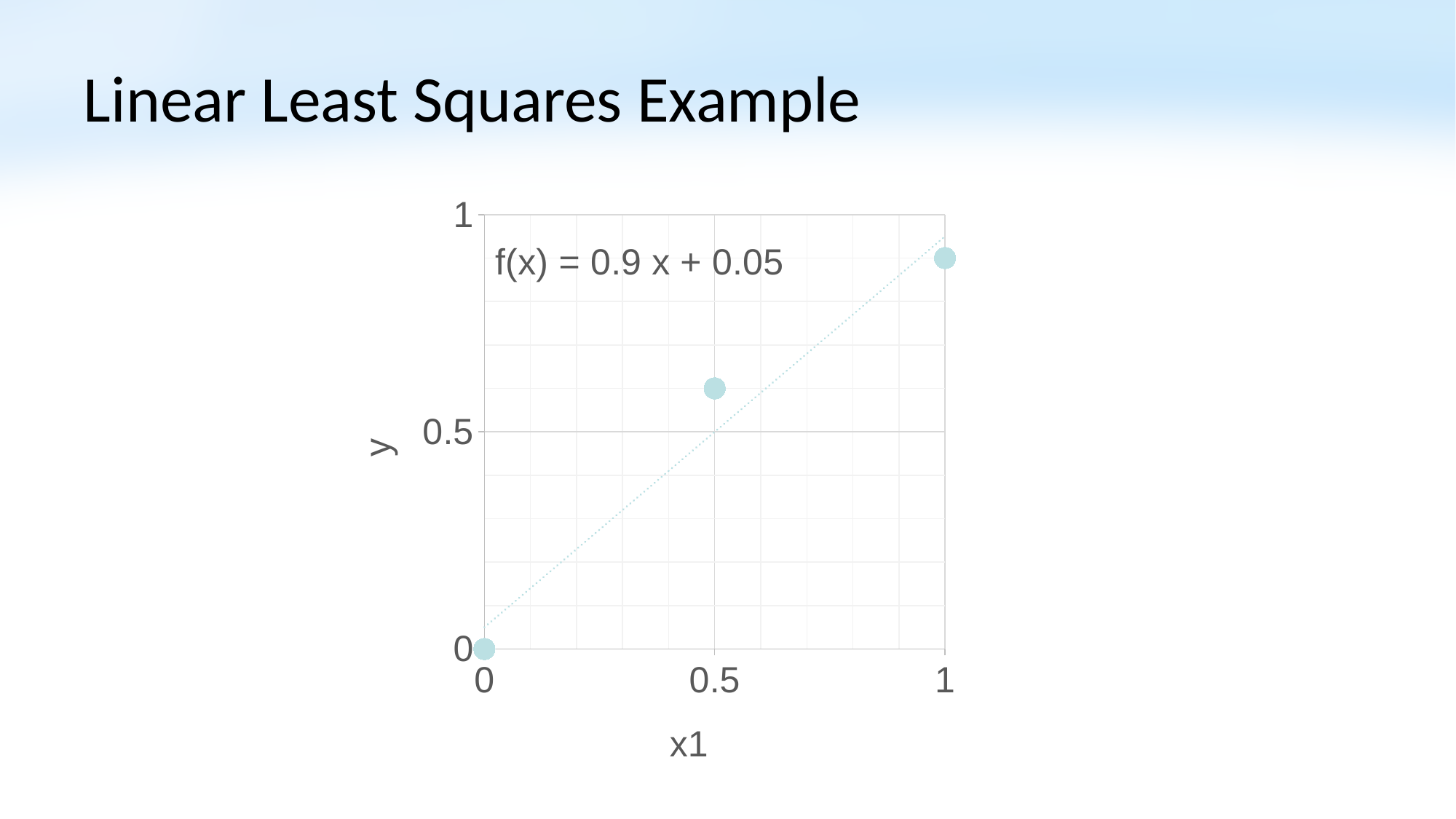
At which x1 value is the plotted y value lowest? 0 What equation for the fitted line is printed on the chart? f(x) = 0.9 x + 0.05 What kind of chart is shown on the slide? scatter chart Is the y value of the point at x1 = 1 greater or less than 0.5? greater How many data points are plotted on the chart? 3 Which point has the larger y value, the one at x1 = 0.5 or the one at x1 = 1? x1 = 1 What is the label of the horizontal axis? x1 At which x1 value is the plotted y value highest? 1 Do the y values rise or fall as x1 increases? rise What is the y value of the point at x1 = 0? 0 Is the y value of the point at x1 = 0.5 greater or less than 0.5? greater What is the slope of the fitted line shown in the equation on the chart? 0.9